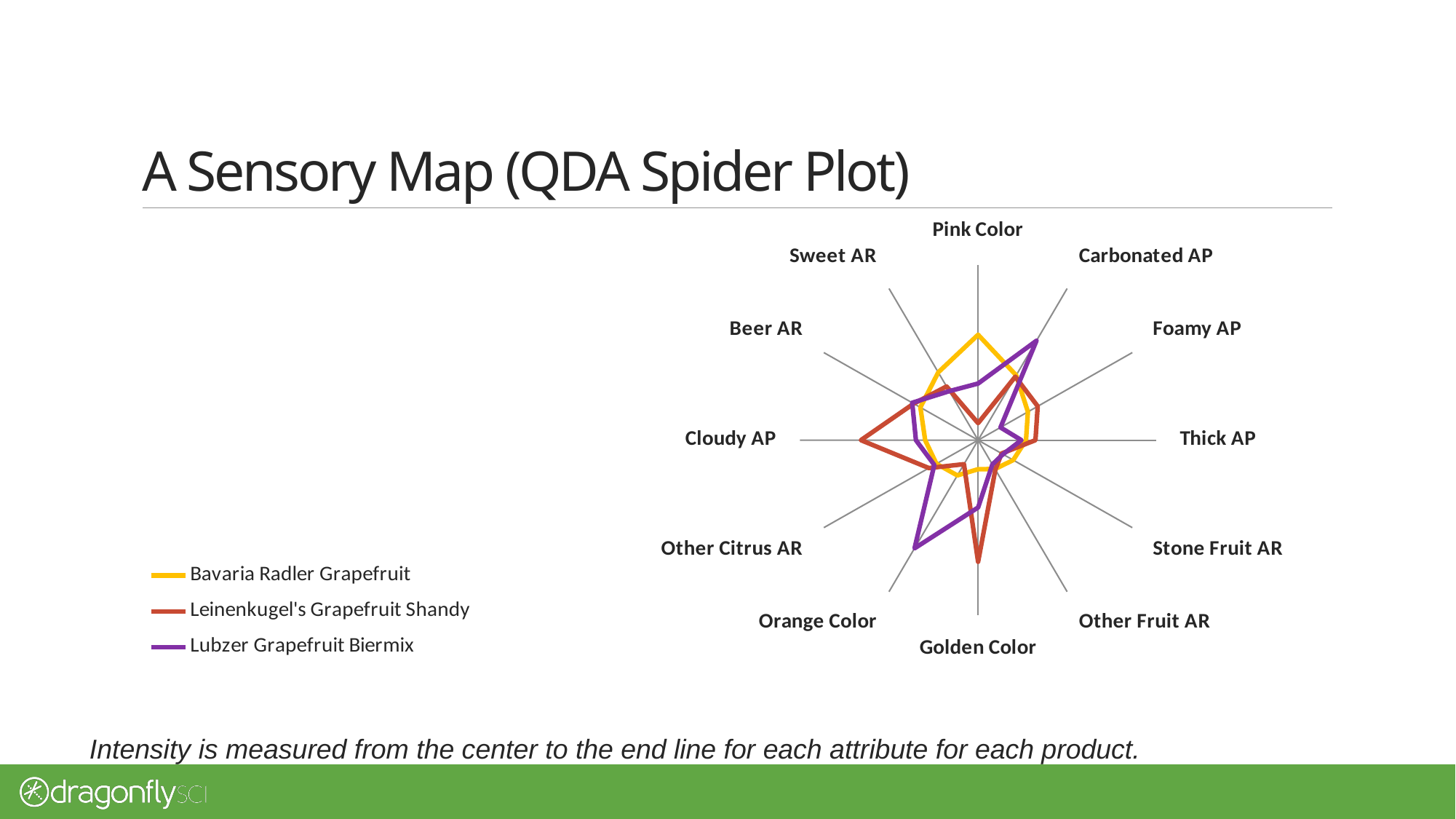
Which product has the highest intensity for Pink Color? Bavaria Radler Grapefruit Which product has the lowest intensity for Golden Color? Bavaria Radler Grapefruit Which product has the highest intensity for Orange Color? Lubzer Grapefruit Biermix What kind of chart is shown on the slide? Radar (spider) chart Which product has the highest intensity for Cloudy AP? Leinenkugel's Grapefruit Shandy For Cloudy AP, which has the higher intensity: Leinenkugel's Grapefruit Shandy or Bavaria Radler Grapefruit? Leinenkugel's Grapefruit Shandy For Pink Color, which has the higher intensity: Bavaria Radler Grapefruit or Lubzer Grapefruit Biermix? Bavaria Radler Grapefruit How many attributes (axes) are plotted on the spider plot? 12 How many products (series) does the legend list? 3 What colour is the line for Lubzer Grapefruit Biermix in the legend? Purple